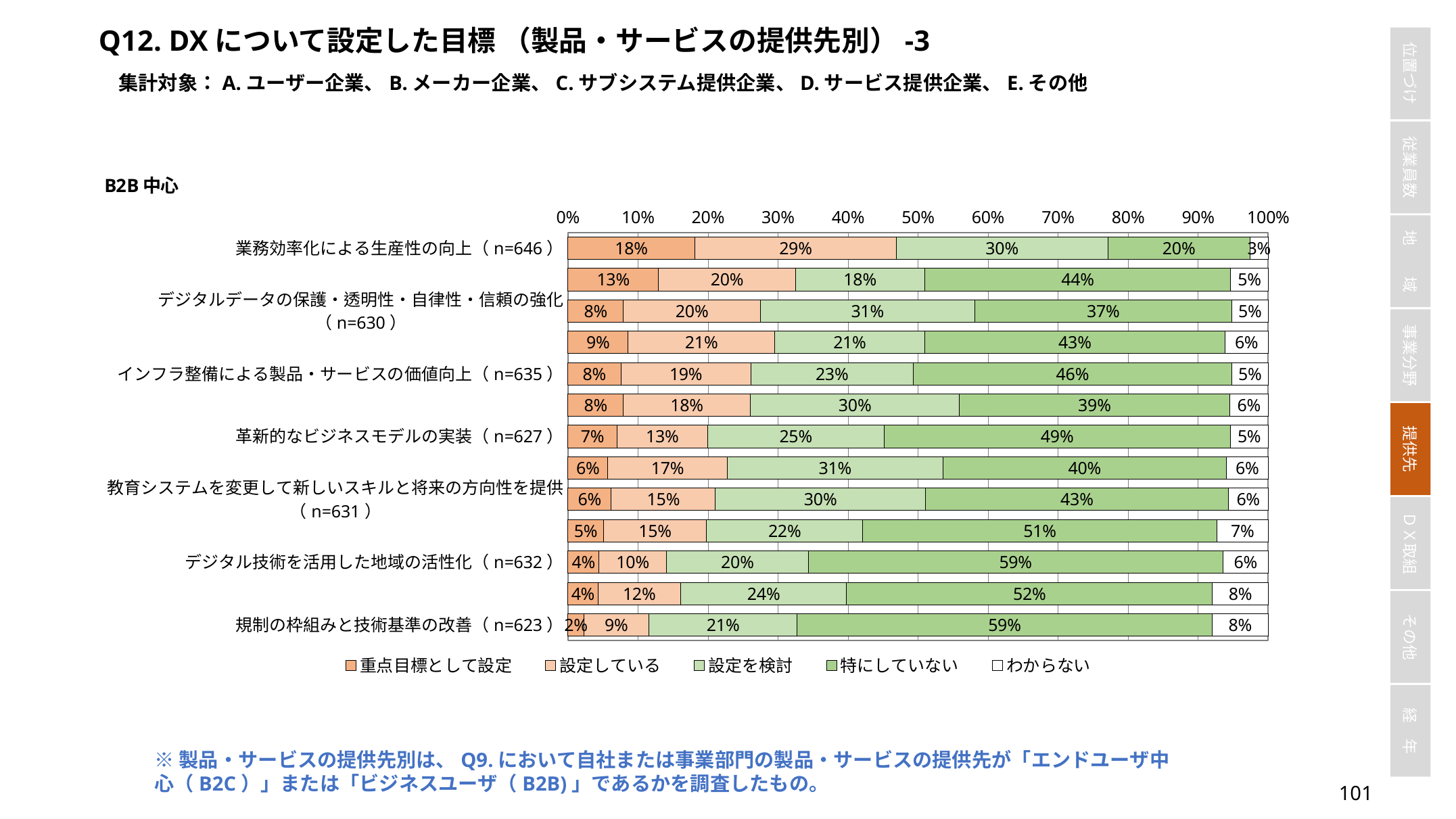
For 業務効率化による生産性の向上 (n=646), how much larger is 設定している than 重点目標として設定? 11 percentage points What kind of chart is shown on the slide? Stacked bar chart Which segment is the largest in the bar for 規制の枠組みと技術基準の改善 (n=623)? 特にしていない What is the first entry in the legend? 重点目標として設定 What is the value of 特にしていない for 規制の枠組みと技術基準の改善 (n=623)? 59% Which has the larger 重点目標として設定 value: 業務効率化による生産性の向上 or 規制の枠組みと技術基準の改善? 業務効率化による生産性の向上 What is the value of わからない for 規制の枠組みと技術基準の改善 (n=623)? 8% What is the value of 特にしていない for 革新的なビジネスモデルの実装 (n=627)? 49% What is the value of 設定している for 業務効率化による生産性の向上 (n=646)? 29% What is the value of 重点目標として設定 for 業務効率化による生産性の向上 (n=646)? 18% How many series does the legend list? 5 What is the value of 重点目標として設定 for デジタル技術を活用した地域の活性化 (n=632)? 4%